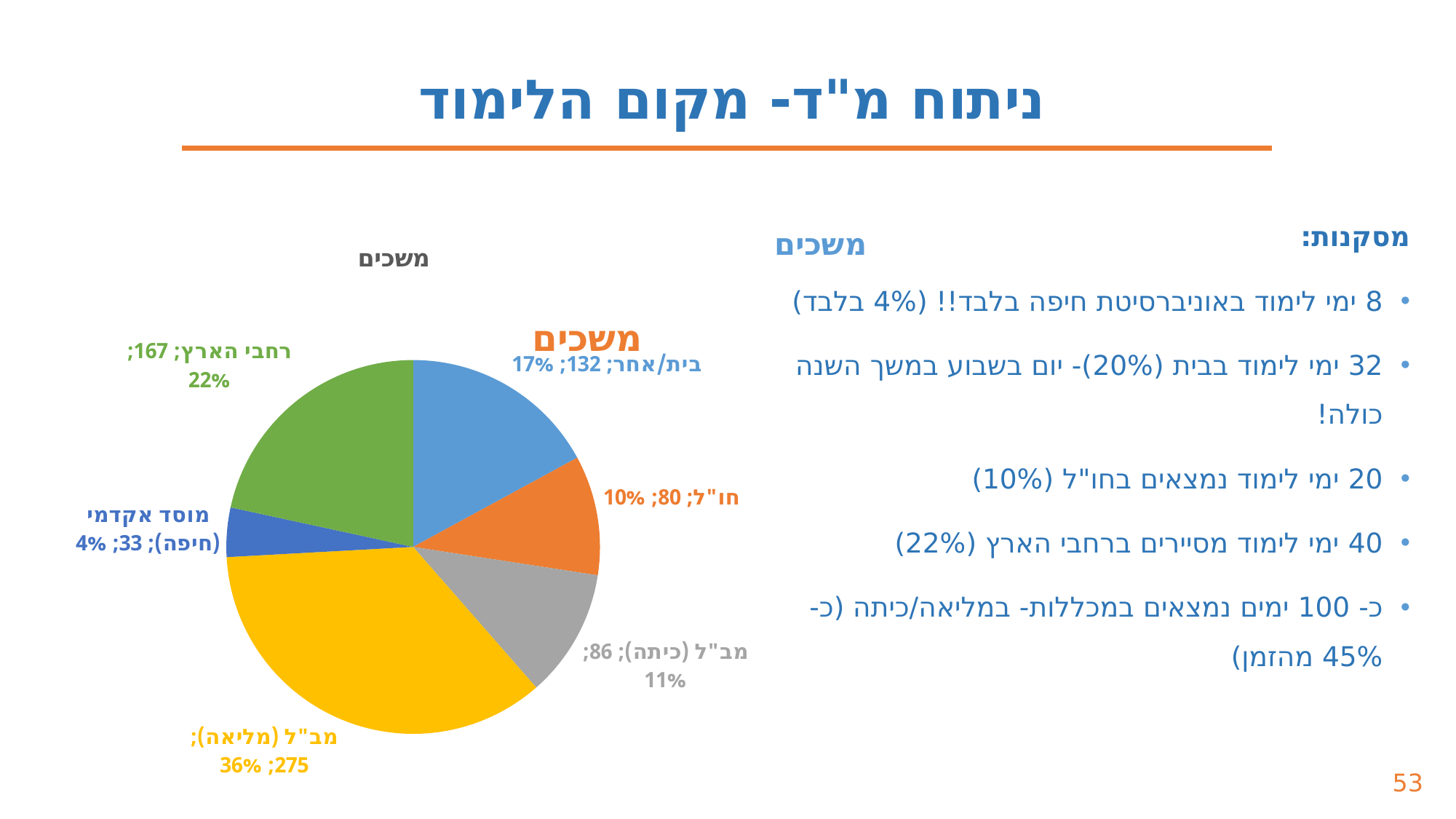
What colour is the slice for מב"ל (מליאה)? yellow What kind of chart is shown on the slide? pie chart What is the title of the pie chart? משכים What percentage share does רחבי הארץ have in the pie chart? 22% How many slices does the pie chart have? 6 Which category has the largest slice in the pie chart? מב"ל (מליאה) What percentage share does חו"ל have in the pie chart? 10% Which category has the smallest slice in the pie chart? מוסד אקדמי (חיפה) What is the difference between the values for מב"ל (מליאה) and רחבי הארץ? 108 What is the value for מב"ל (מליאה) in the pie chart? 275 Which is larger, the value for מב"ל (כיתה) or the value for חו"ל? מב"ל (כיתה) What is the value for בית/אחר in the pie chart? 132